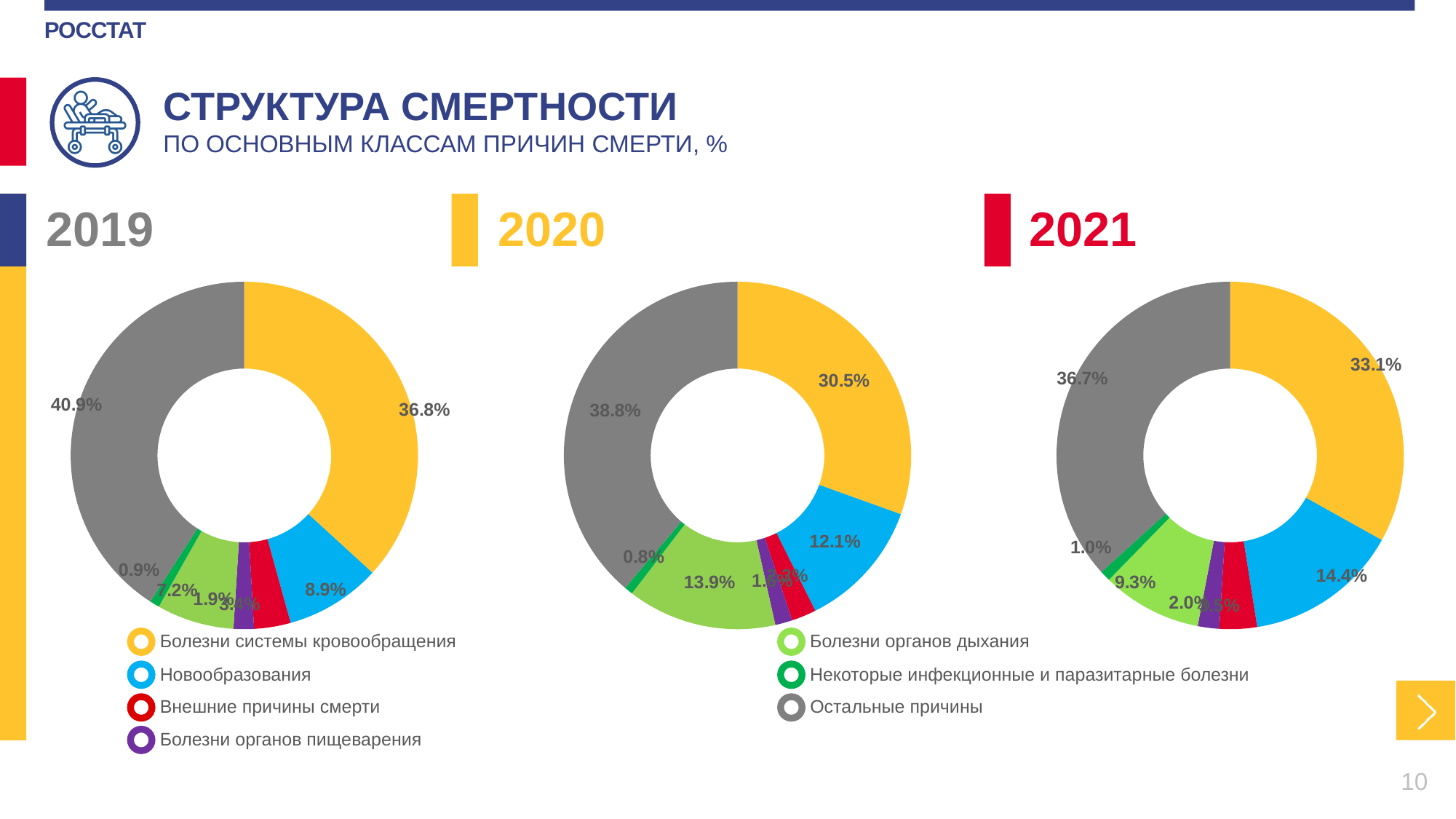
In the 2020 chart, what is the share for Болезни органов дыхания? 13.9% In the 2021 chart, which is larger: Новообразования or Болезни органов дыхания? Новообразования What kind of chart is used for each year on this slide? Donut (pie) chart In the 2021 chart, what is the share for Болезни системы кровообращения? 33.1% In the 2020 chart, which category has the smallest share? Некоторые инфекционные и паразитарные болезни In the 2019 chart, what is the share for Болезни системы кровообращения? 36.8% In the 2019 chart, which category has the largest share? Остальные причины In the 2019 chart, what is the share for Остальные причины? 40.9% In the 2020 chart, what is the share for Новообразования? 12.1% What is the difference between the share of Болезни системы кровообращения in the 2019 chart and in the 2020 chart? 6.3% In the 2021 chart, what is the share for Некоторые инфекционные и паразитарные болезни? 1.0% How many categories does the legend list? 7